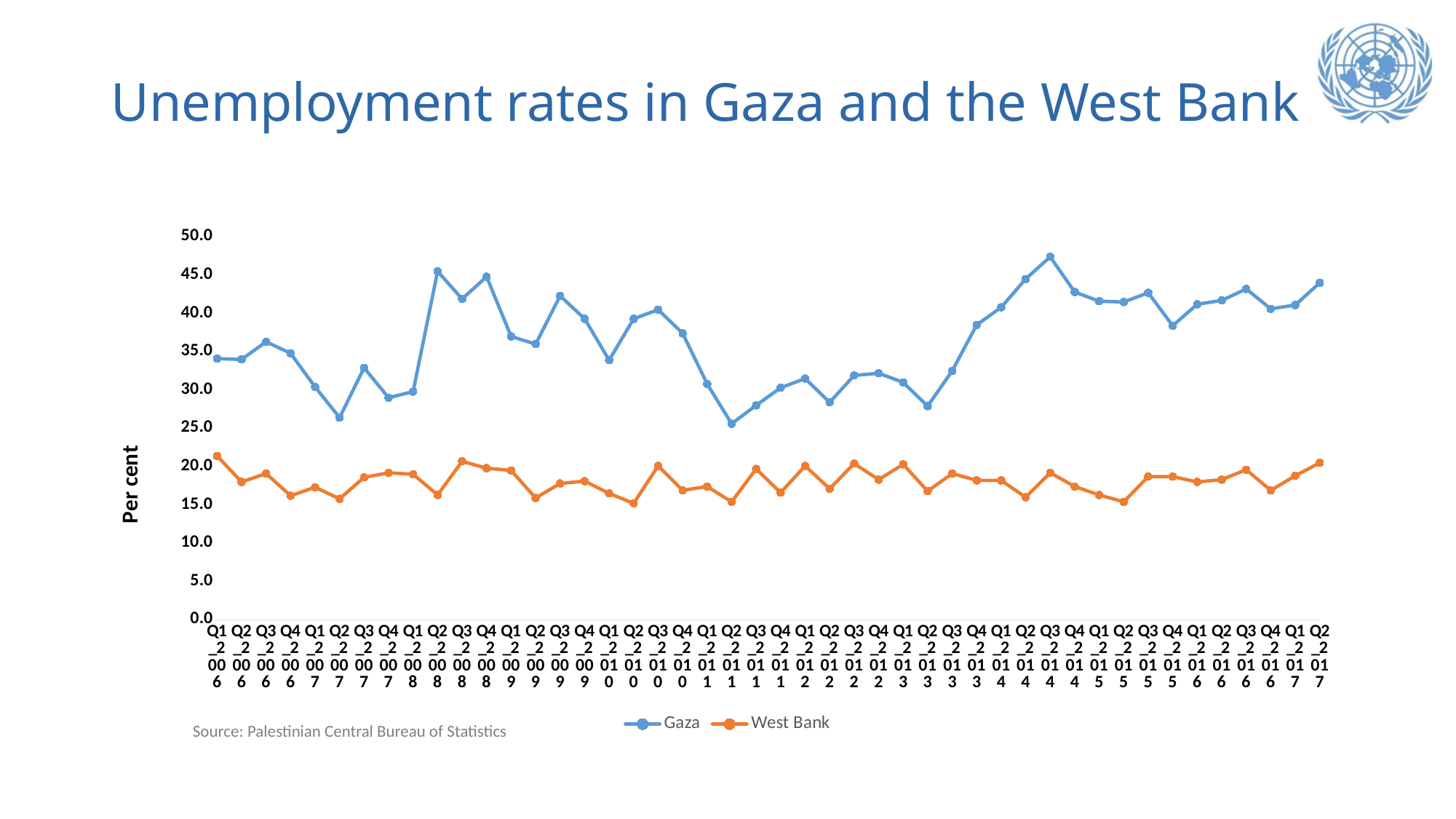
In which quarter does the Gaza series reach its highest value? Q3_2014 Is the Gaza value for Q3_2014 greater or less than 45? greater Is the Gaza value for Q2_2017 greater or less than 40? greater How many series does the legend list? 2 Does the Gaza series rise or fall between Q2_2013 and Q3_2014? rise What kind of chart is shown on the slide? line chart Which two series are shown in the legend? Gaza and West Bank Is the West Bank value for Q2_2010 greater or less than 20? less How many quarterly data points are plotted for each series? 46 What is the label on the vertical axis? Per cent Which series has the larger value in Q2_2017, Gaza or West Bank? Gaza